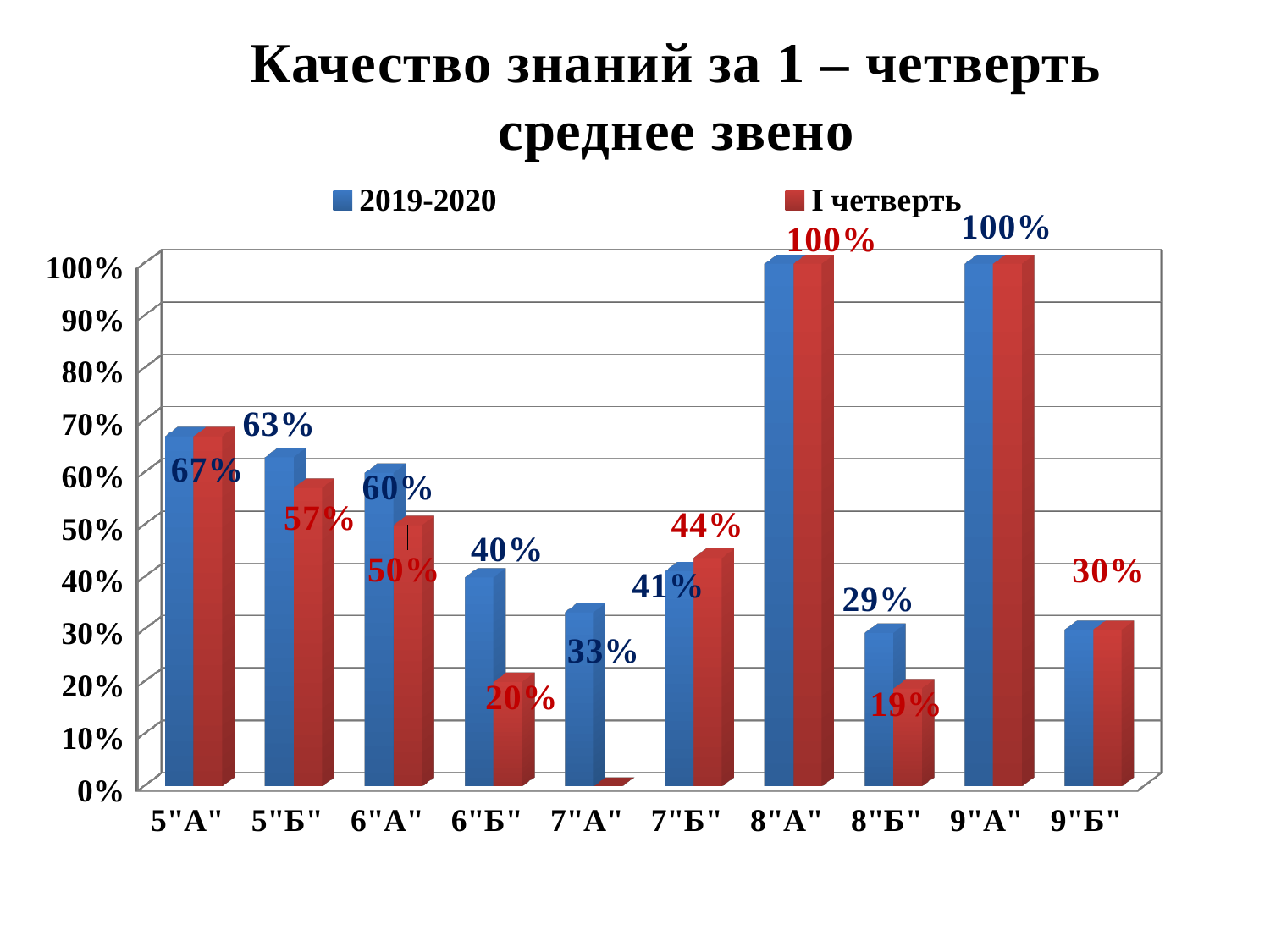
How many series does the legend list? 2 Is the I четверть value for class 5"А" greater or less than 60%? greater For class 7"Б", which series has the larger value, 2019-2020 or I четверть? I четверть What is the 2019-2020 value for class 8"Б"? 29% What kind of chart is shown on the slide? bar chart What is the 2019-2020 value for class 5"Б"? 63% What are the two entries in the chart legend? 2019-2020 and I четверть What is the I четверть value for class 6"Б"? 20% Which class has the lowest I четверть value? 7"А" How many classes (categories) are shown on the x axis? 10 What is the I четверть value for class 7"Б"? 44% What is the difference between the 2019-2020 and I четверть values for class 6"А"? 10 percentage points